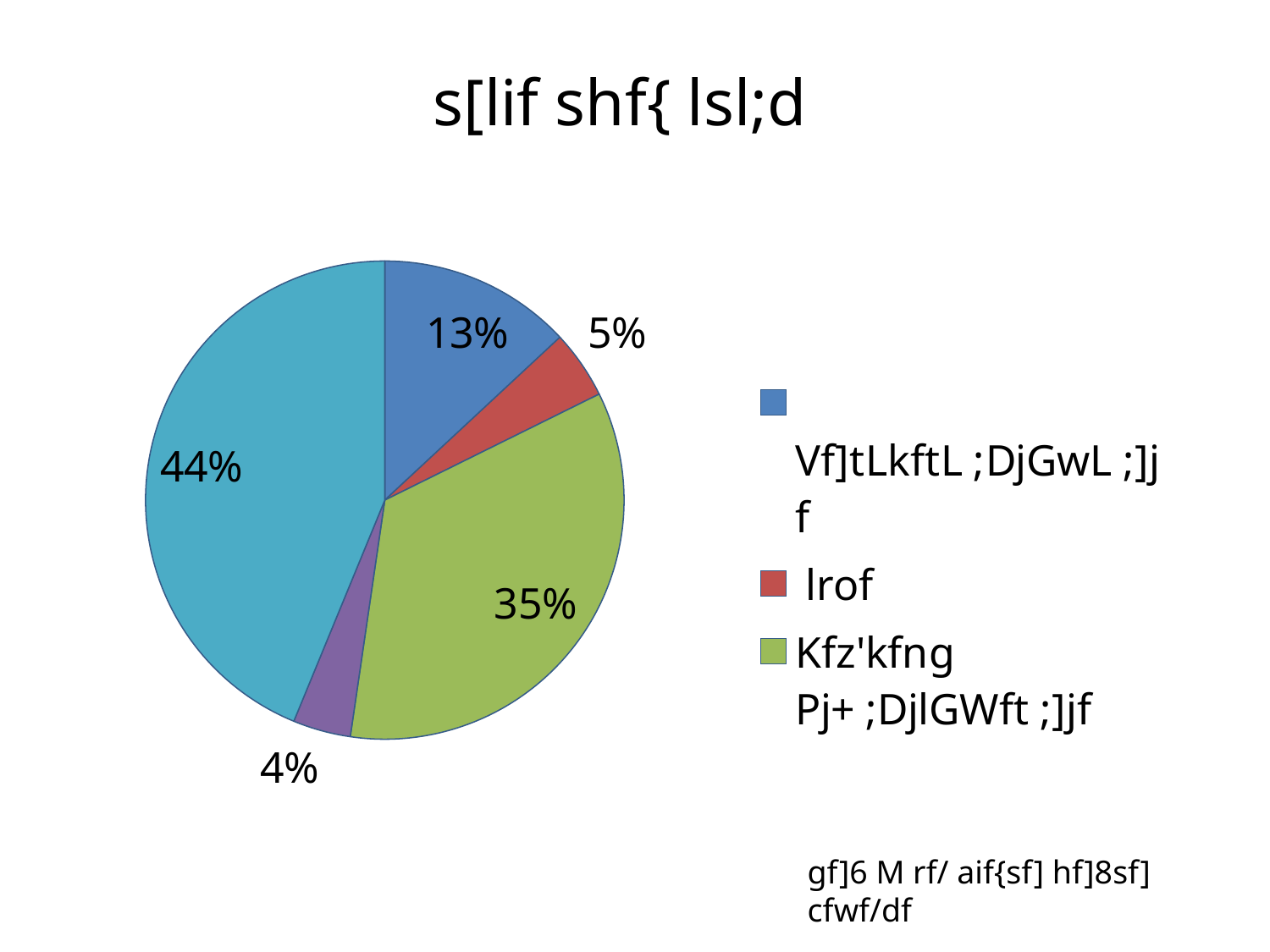
How many entries does the legend of the pie chart list? 3 What percentage is shown for the red slice of the pie chart? 5% What kind of chart is shown on the slide? pie chart Which slice of the pie chart is the largest? the teal slice (44%) Which is larger, the blue slice or the red slice? the blue slice What is the difference in percentage points between the teal slice and the green slice? 9 What percentage is shown for the green slice of the pie chart? 35% Which slice of the pie chart is the smallest? the purple slice (4%) What percentage is shown for the blue slice of the pie chart? 13% What percentage is shown for the purple slice of the pie chart? 4% How many slices does the pie chart have? 5 What percentage is shown for the teal (light blue) slice of the pie chart? 44%